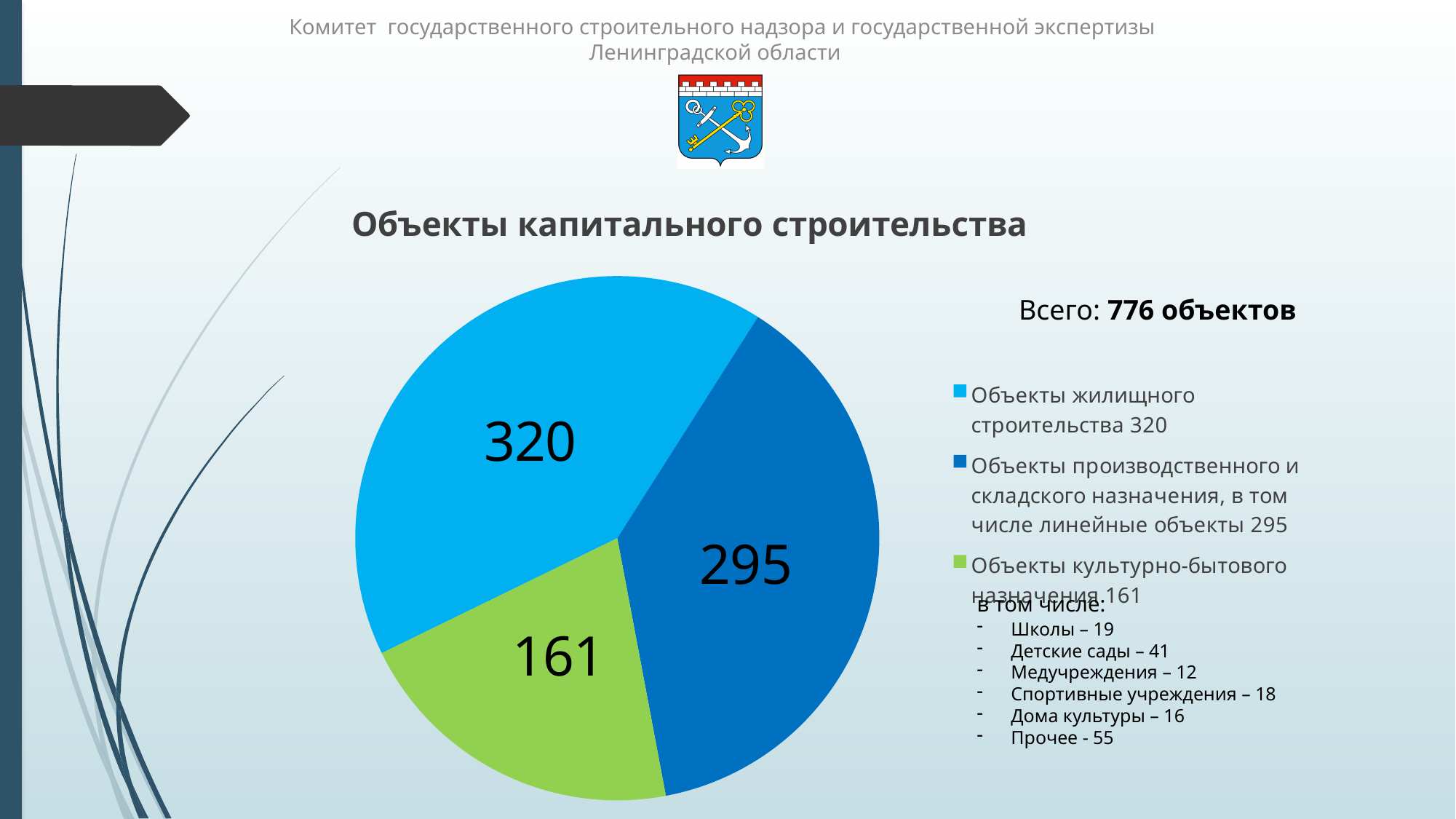
What is the value for Объекты жилищного строительства? 320 Which is larger: the value for Объекты производственного и складского назначения or the value for Объекты культурно-бытового назначения? Объекты производственного и складского назначения How many slices does the pie chart have? 3 What is the total of all slices in the pie chart? 776 What is the value for Объекты культурно-бытового назначения? 161 Which category has the smallest slice of the pie? Объекты культурно-бытового назначения What is the difference between the values for Объекты производственного и складского назначения and Объекты культурно-бытового назначения? 134 What kind of chart is shown on the slide? pie chart What is the difference between the values for Объекты жилищного строительства and Объекты производственного и складского назначения? 25 What is the title of the chart? Объекты капитального строительства Which category has the largest slice of the pie? Объекты жилищного строительства What is the value for Объекты производственного и складского назначения, в том числе линейные объекты? 295